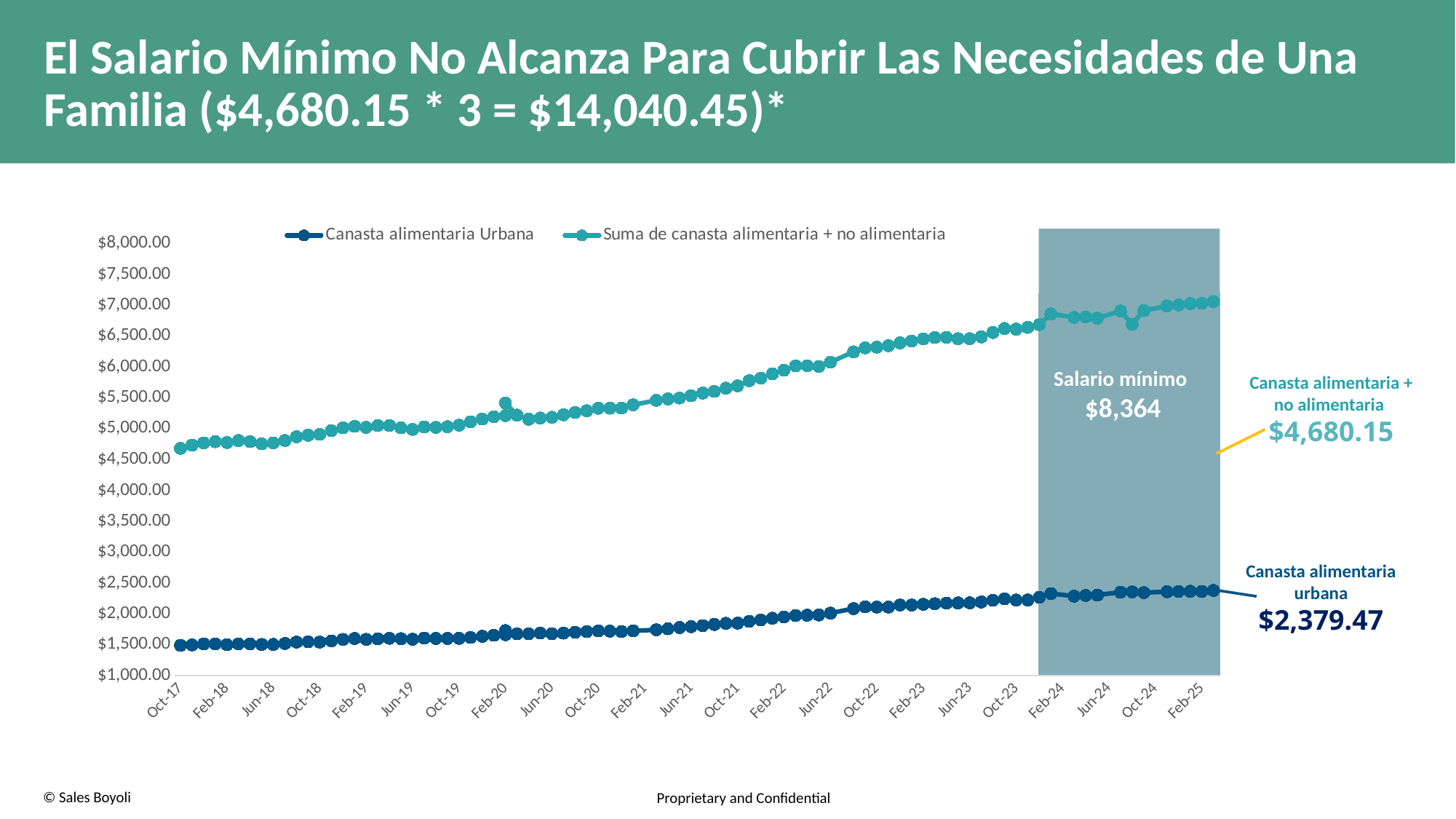
Is the value of Suma de canasta alimentaria + no alimentaria at Feb-25 greater or less than $6,500.00? greater Which series is plotted higher on the chart, Canasta alimentaria Urbana or Suma de canasta alimentaria + no alimentaria? Suma de canasta alimentaria + no alimentaria What is the difference between the annotated values for Canasta alimentaria + no alimentaria ($4,680.15) and Canasta alimentaria urbana ($2,379.47)? $2,300.68 What value is annotated on the chart for Canasta alimentaria urbana? $2,379.47 What type of chart is shown on the slide? line chart Do the values of the Suma de canasta alimentaria + no alimentaria series rise or fall from Oct-17 to Feb-25? rise What value is annotated on the chart for Canasta alimentaria + no alimentaria? $4,680.15 What are the two series named in the chart legend? Canasta alimentaria Urbana; Suma de canasta alimentaria + no alimentaria What value is shown for Salario mínimo in the shaded area of the chart? $8,364 How many series does the chart legend list? 2 What is the first date label on the x axis of the chart? Oct-17 Is the value of Canasta alimentaria Urbana at Oct-17 greater or less than $2,000.00? less